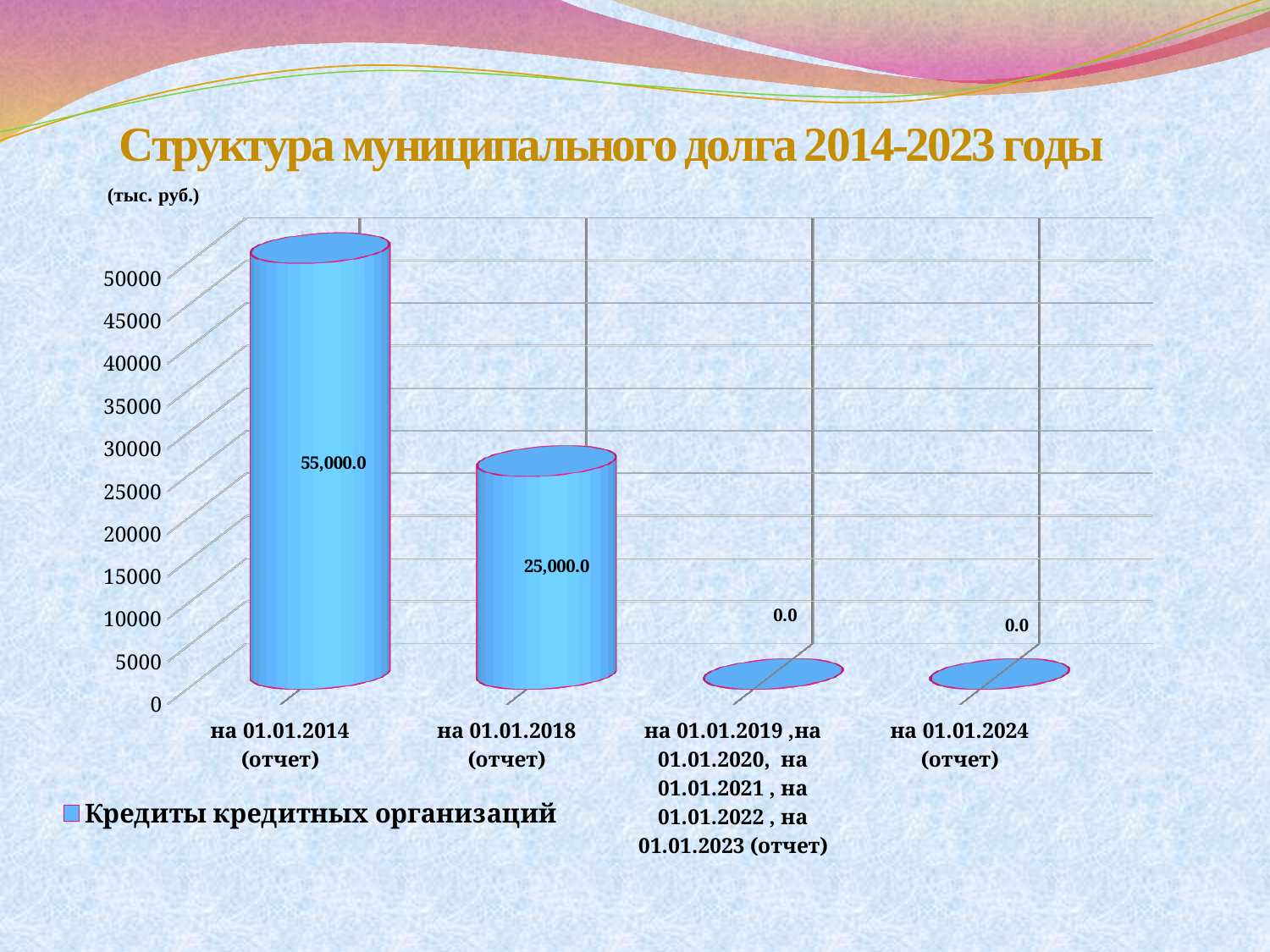
How many categories are shown on the x axis? 4 Do the values rise or fall from left to right along the x axis? fall What is the value for "на 01.01.2014 (отчет)"? 55,000.0 What is the value for "на 01.01.2024 (отчет)"? 0.0 What is the title of the chart? Структура муниципального долга 2014-2023 годы What is the value for "на 01.01.2018 (отчет)"? 25,000.0 How many series does the legend list? 1 Which is larger, the value for "на 01.01.2014 (отчет)" or for "на 01.01.2018 (отчет)"? на 01.01.2014 (отчет) Which category has the highest value? на 01.01.2014 (отчет) What kind of chart is shown on the slide? bar chart Is the value for "на 01.01.2018 (отчет)" greater or less than 30000? less What is the difference between the values for "на 01.01.2014 (отчет)" and "на 01.01.2018 (отчет)"? 30,000.0